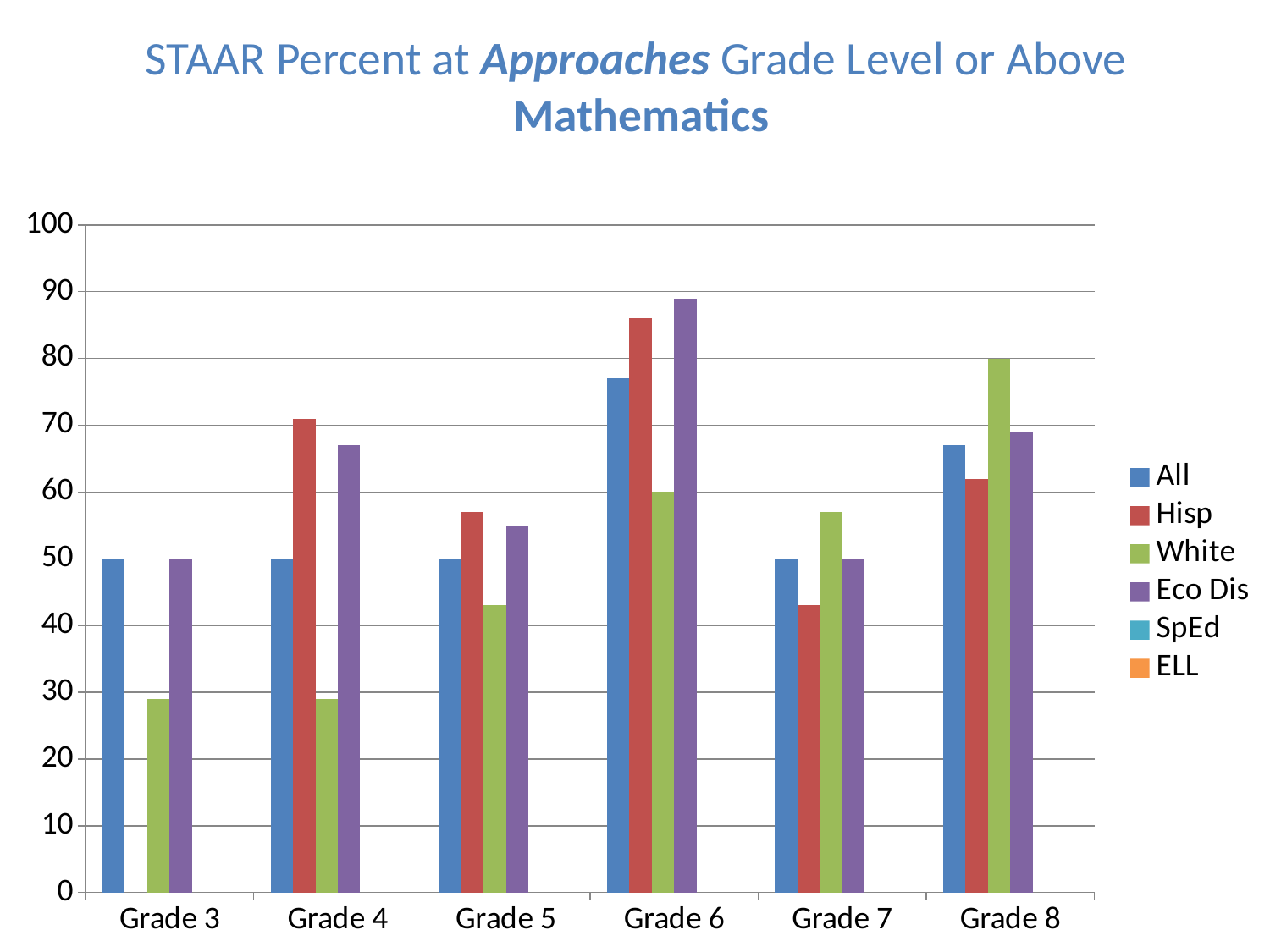
What is the value for White in Grade 8? 80 Is the value for Eco Dis in Grade 4 greater or less than 70? less How many series does the legend list? 6 Which series is shown in green in the legend? White In Grade 6, which is larger, the Hisp value or the White value? Hisp Is the value for Eco Dis in Grade 6 greater or less than 80? greater What type of chart is shown on the slide? Bar chart What is the value for All in Grade 3? 50 How many grade categories are shown on the x axis? 6 Which grade has the highest value for the All series? Grade 6 What is the value for White in Grade 6? 60 Which grade has the lowest value for the Hisp series? Grade 7